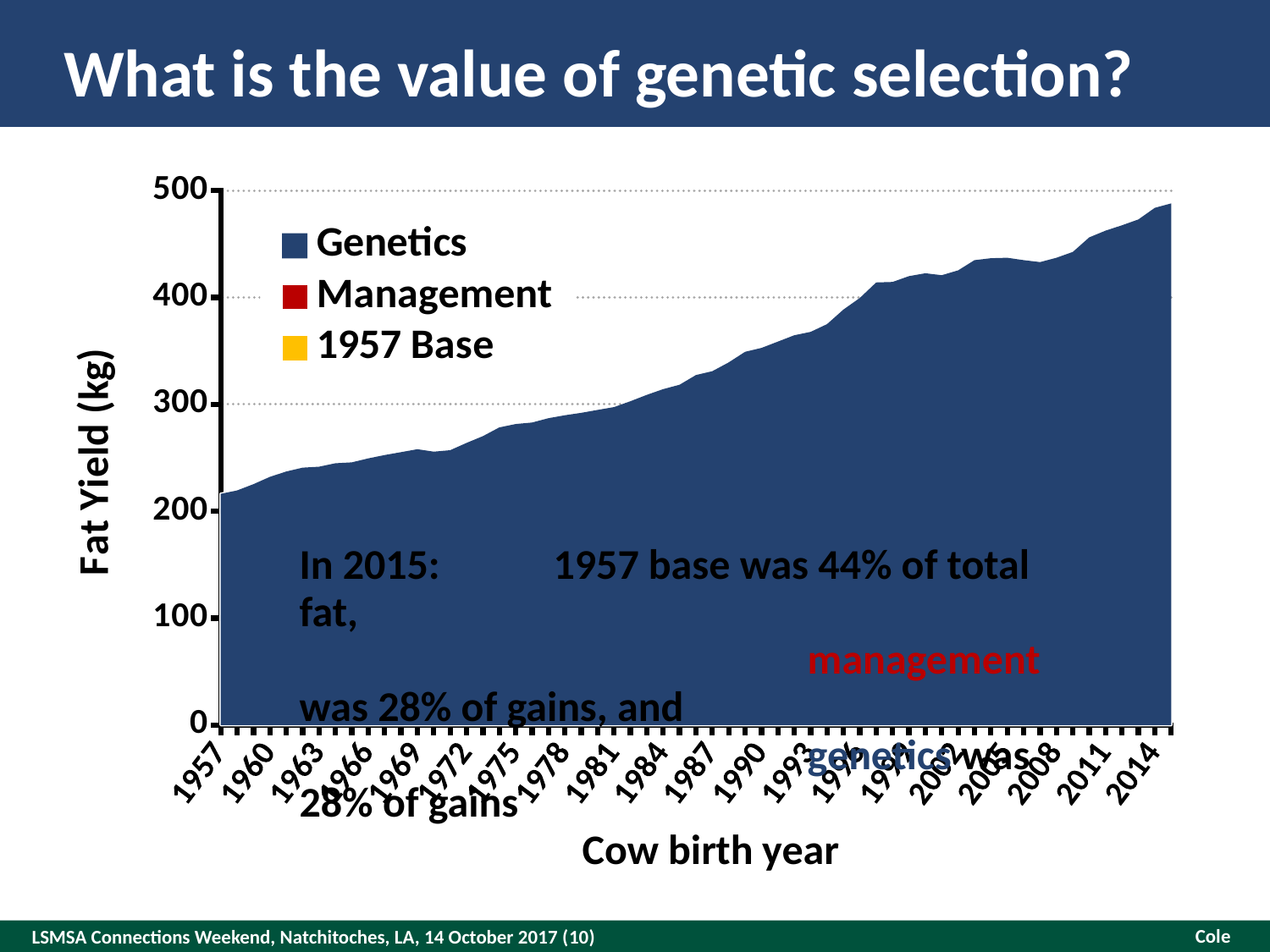
Is the fat yield value for cow birth year 1957 greater or less than 200? greater What kind of chart is shown on the slide? Area chart Does the plotted fat yield rise or fall as cow birth year increases from 1957 to 2014? Rises Is the fat yield value for cow birth year 2014 greater or less than 400? greater What is the title of the vertical axis of the chart? Fat Yield (kg) Is the fat yield value for cow birth year 2005 greater or less than 400? greater What is the first cow birth year labelled on the x axis of the chart? 1957 How many series does the chart legend list? 3 Which cow birth year has the higher fat yield, 1963 or 1999? 1999 What are the three series named in the chart legend? Genetics, Management, 1957 Base